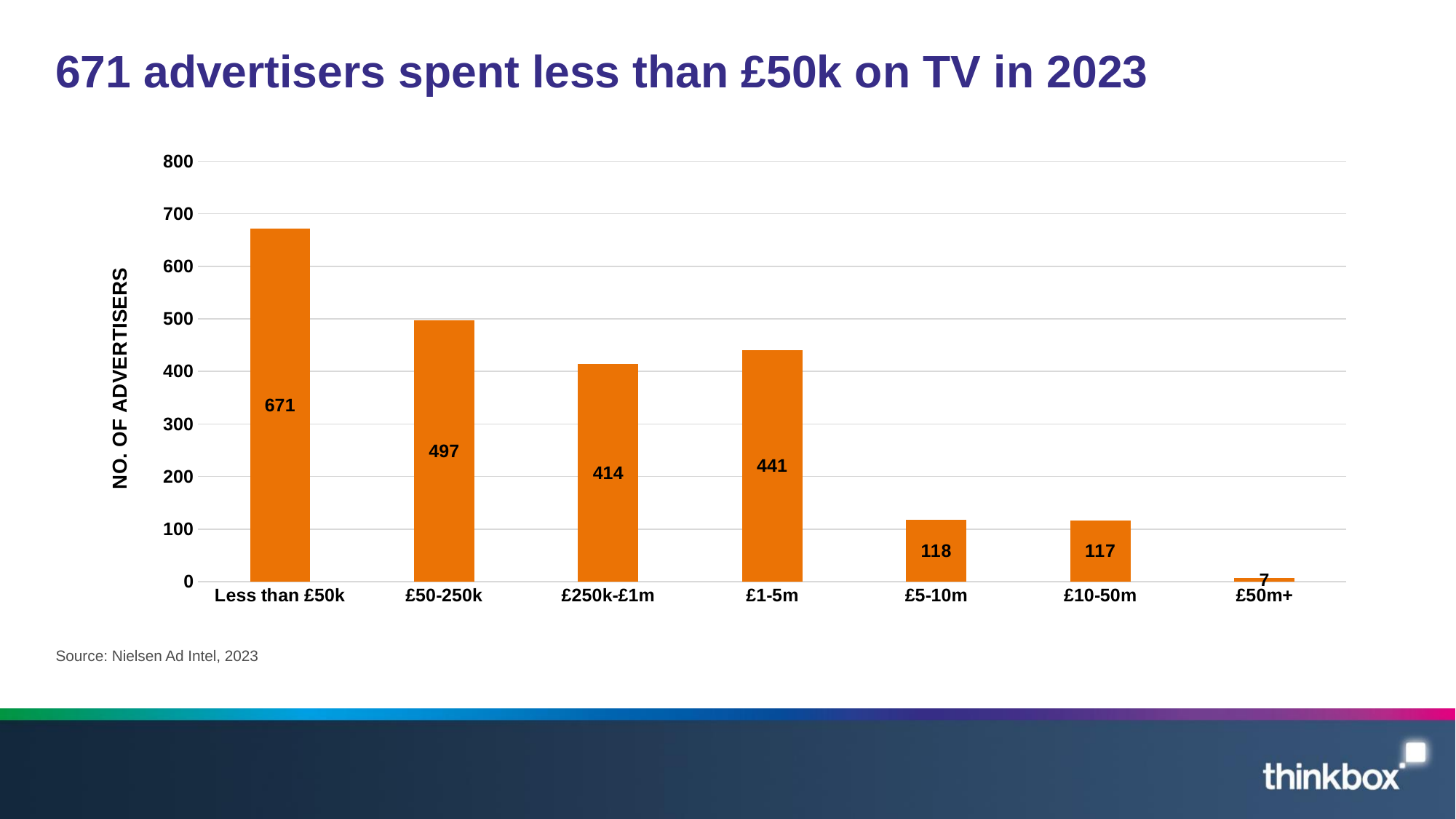
Which spend band has the lowest number of advertisers? £50m+ How many advertisers spent £50-250k on TV in 2023? 497 What is the label of the y axis? NO. OF ADVERTISERS What is the number of advertisers in the £1-5m spend band? 441 Which has more advertisers, £250k-£1m or £1-5m? £1-5m What is the difference between the £1-5m and £250k-£1m bands? 27 How many advertisers are shown for the £50m+ category? 7 Is the value for £5-10m greater or less than 200? less How many spend bands are shown on the x axis? 7 What kind of chart is shown on the slide? Bar chart What is the difference in the number of advertisers between the Less than £50k band and the £50-250k band? 174 Which spend band has the highest number of advertisers? Less than £50k